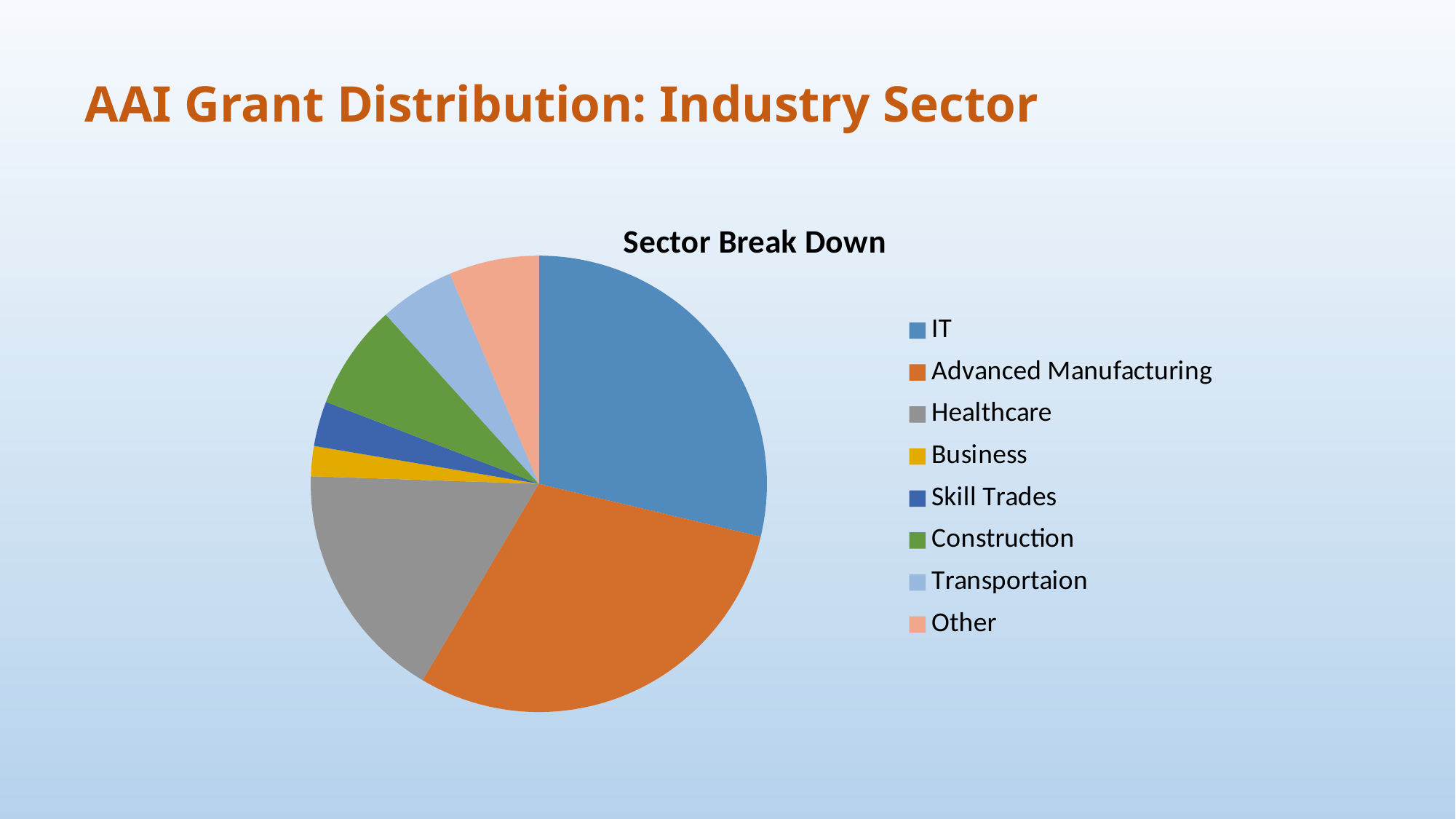
How many sectors (slices) does the pie chart show? 8 Which slice is larger, Skill Trades or Other? Other Which slice is larger, Healthcare or Construction? Healthcare What kind of chart is shown on the slide? Pie chart Which slice is larger, Business or Construction? Construction What is the title of the chart? Sector Break Down Which sector has the smallest slice of the pie? Business How many entries does the legend list? 8 Which sector is shown in yellow in the pie chart? Business